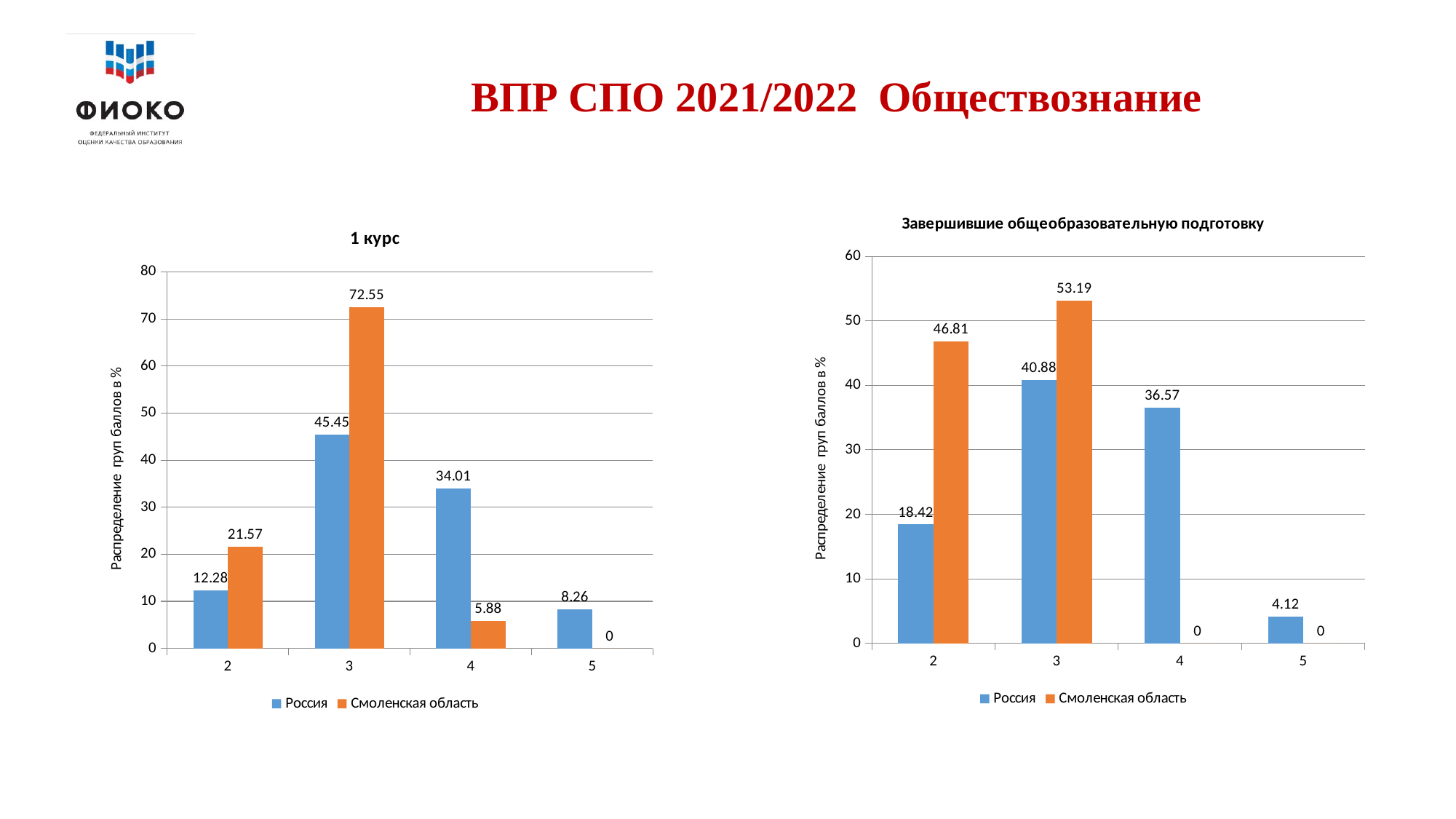
In the '1 курс' chart, what is the value for Смоленская область at category 3? 72.55 In the 'Завершившие общеобразовательную подготовку' chart, which category has the lowest value for Россия? 5 In the 'Завершившие общеобразовательную подготовку' chart, how many series does the legend list? 2 In the 'Завершившие общеобразовательную подготовку' chart, how many categories are shown on the x axis? 4 In the 'Завершившие общеобразовательную подготовку' chart, what is the difference between Смоленская область and Россия at category 2? 28.39 In the '1 курс' chart, which is larger at category 4: Россия or Смоленская область? Россия What kind of chart is the '1 курс' chart? Bar chart In the '1 курс' chart, what is the difference between Смоленская область and Россия at category 2? 9.29 In the '1 курс' chart, which category has the highest value for Россия? 3 In the '1 курс' chart, what is the value for Россия at category 4? 34.01 In the 'Завершившие общеобразовательную подготовку' chart, what is the value for Россия at category 3? 40.88 In the '1 курс' chart, what is the value for Смоленская область at category 5? 0